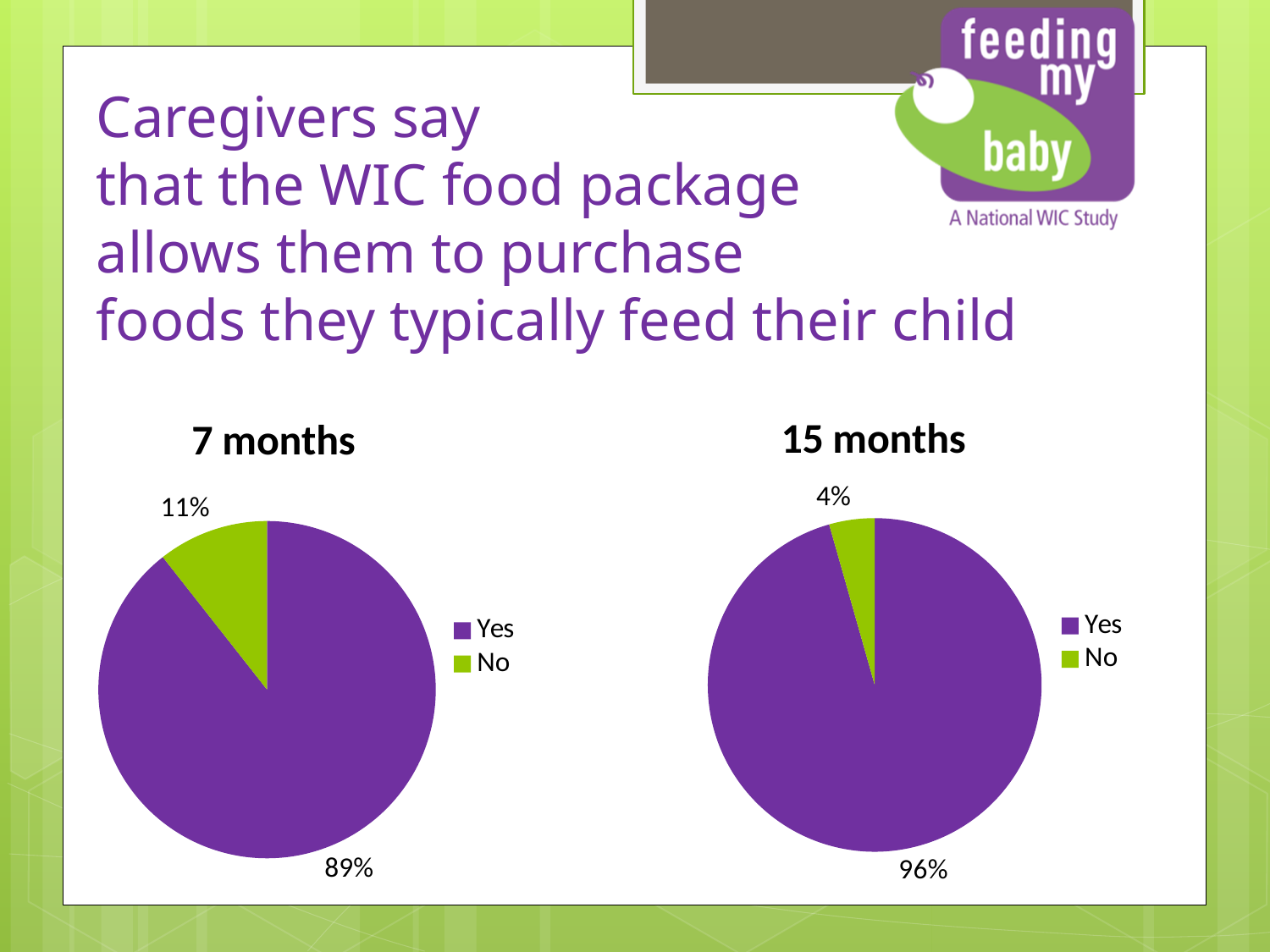
In the '15 months' chart, what percentage of caregivers answered No? 4% In the '7 months' chart, which response has the largest slice? Yes In the '7 months' chart, what percentage of caregivers answered Yes? 89% In the '7 months' chart, what colour represents the No response? Green In the '15 months' chart, which response has the smallest slice? No What type of chart is the '15 months' chart? Pie chart How many slices does the '7 months' pie chart have? 2 In the '15 months' chart, what percentage of caregivers answered Yes? 96% How many entries does the legend of the '15 months' chart list? 2 In the '7 months' chart, what percentage of caregivers answered No? 11% In the '7 months' chart, what is the difference between the Yes and No percentages? 78% Is the Yes percentage larger in the '7 months' chart or the '15 months' chart? 15 months